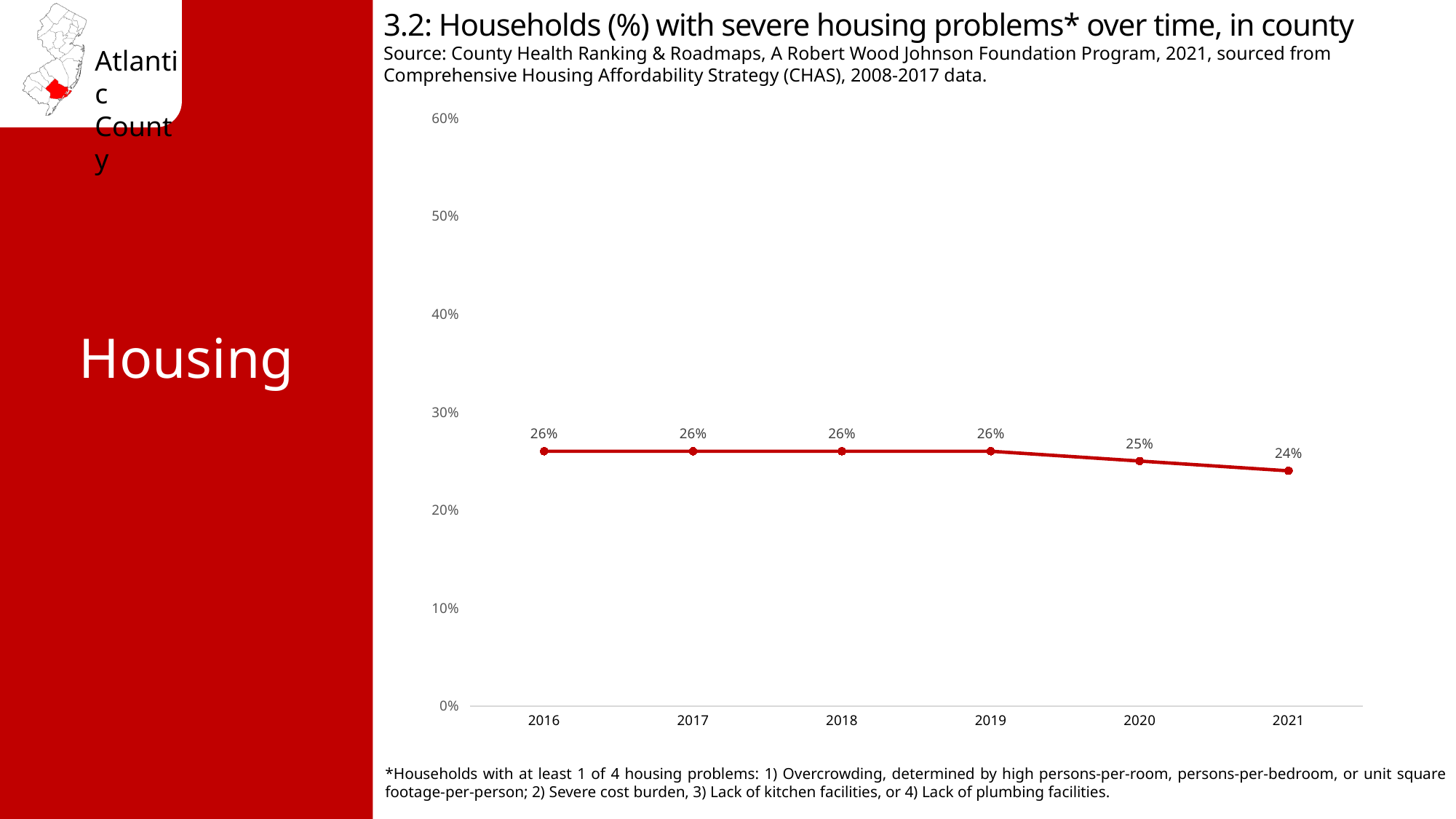
What is the title of the chart? 3.2: Households (%) with severe housing problems* over time, in county Which is larger, the value for 2018 or the value for 2021? 2018 What percentage of households had severe housing problems in 2016? 26% Do the values rise or fall from 2019 to 2021? fall What colour is the line on the chart? red Is the value for 2017 greater or less than 30%? less What is the difference between the 2019 value and the 2021 value? 2% How many years are plotted on the chart? 6 What percentage of households had severe housing problems in 2020? 25% What percentage of households had severe housing problems in 2021? 24% What kind of chart is shown on the slide? line chart Which year has the lowest percentage of households with severe housing problems? 2021